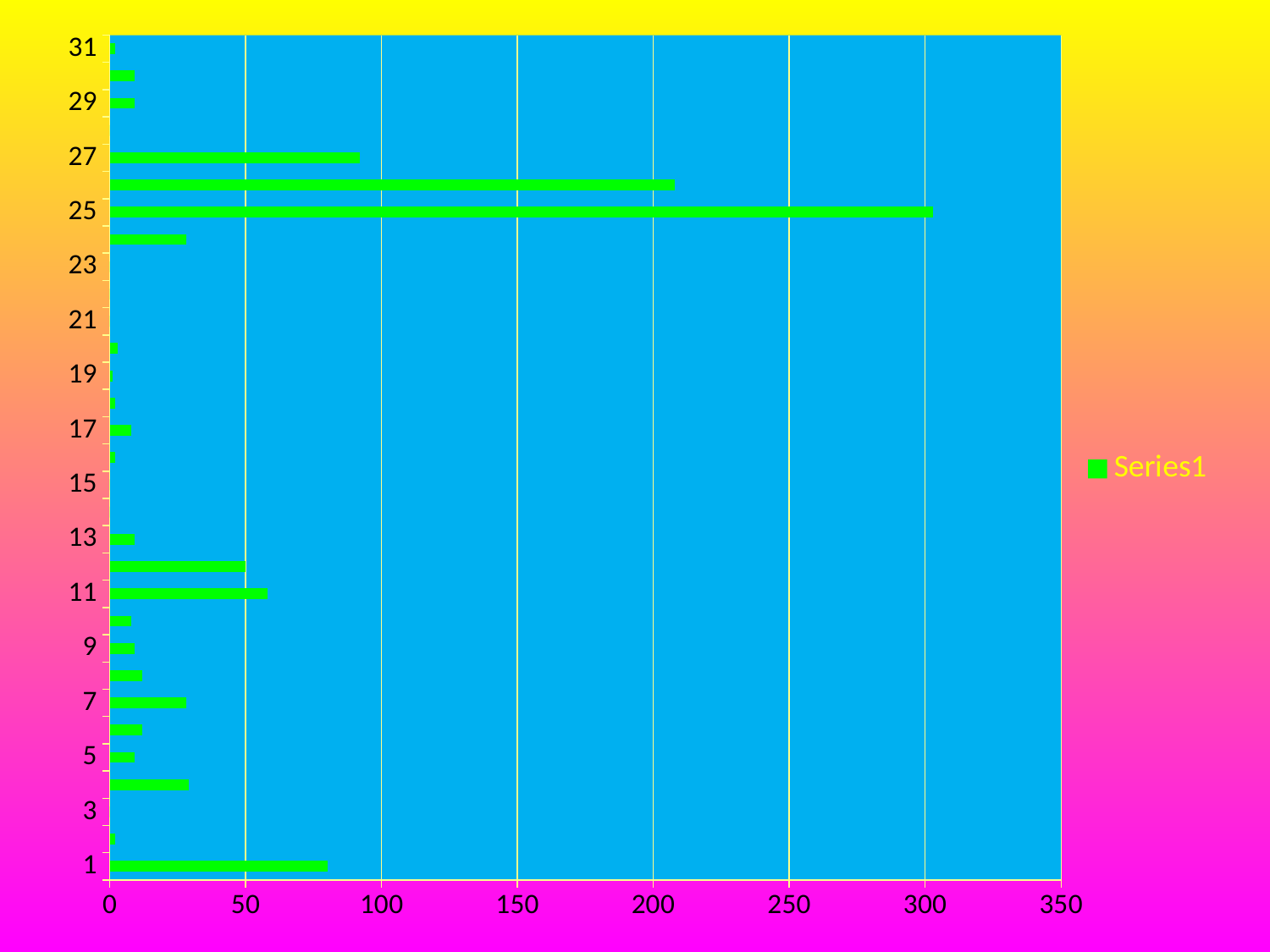
Which is larger, the value for category 7 or category 9? 7 How many series does the legend list? 1 What is the name of the series shown in the legend? Series1 Is the value for category 13 greater or less than 50? less Is the value for category 1 greater or less than 50? greater Is the value for category 27 greater or less than 100? less Which is larger, the value for category 1 or category 11? 1 Which is larger, the value for category 25 or category 27? 25 Which category has the highest value? 25 What kind of chart is shown on the slide? bar chart